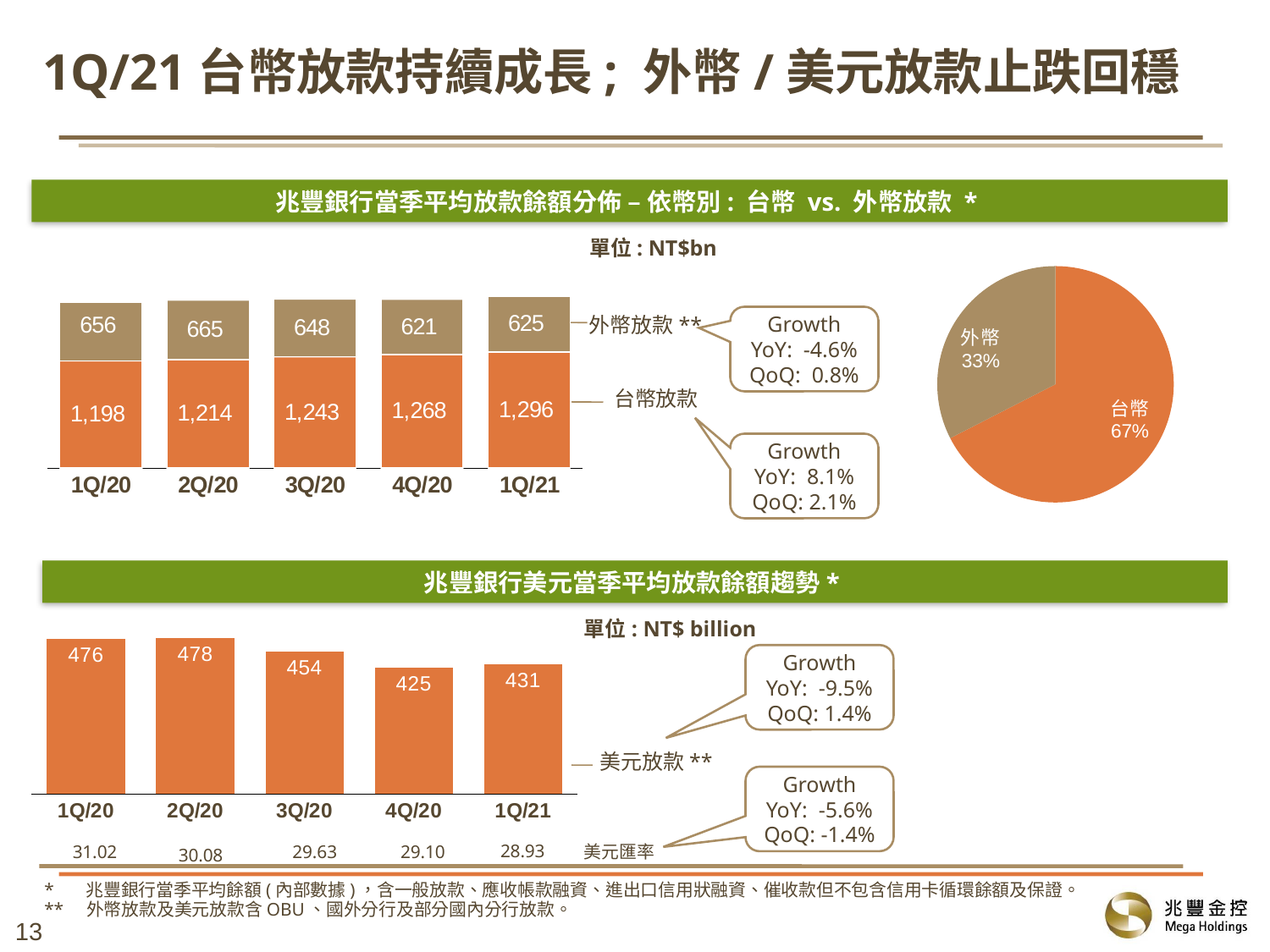
In the top stacked bar chart (台幣 vs. 外幣放款), what is the 台幣放款 value for 1Q/21? 1,296 In the top stacked bar chart (台幣 vs. 外幣放款), what is the difference between the 台幣放款 values for 1Q/21 and 1Q/20? 98 In the top stacked bar chart (台幣 vs. 外幣放款), which quarter has the lowest 外幣放款 value? 4Q/20 What kind of chart is the bottom chart (美元當季平均放款餘額趨勢)? bar chart In the pie chart on the top right, what share does 外幣 have? 33% In the bottom chart (美元當季平均放款餘額趨勢), what is the 美元放款 value for 4Q/20? 425 In the top stacked bar chart (台幣 vs. 外幣放款), does the 台幣放款 series rise or fall from 1Q/20 to 1Q/21? rise In the pie chart on the top right, which slice is larger, 台幣 or 外幣? 台幣 In the bottom chart (美元當季平均放款餘額趨勢), which quarter has the highest 美元放款 value? 2Q/20 In the top stacked bar chart (台幣 vs. 外幣放款), how many quarters are shown on the x axis? 5 In the top stacked bar chart (台幣 vs. 外幣放款), what is the 外幣放款 value for 2Q/20? 665 In the top stacked bar chart (台幣 vs. 外幣放款), what is the total of the 1Q/21 bar? 1,921